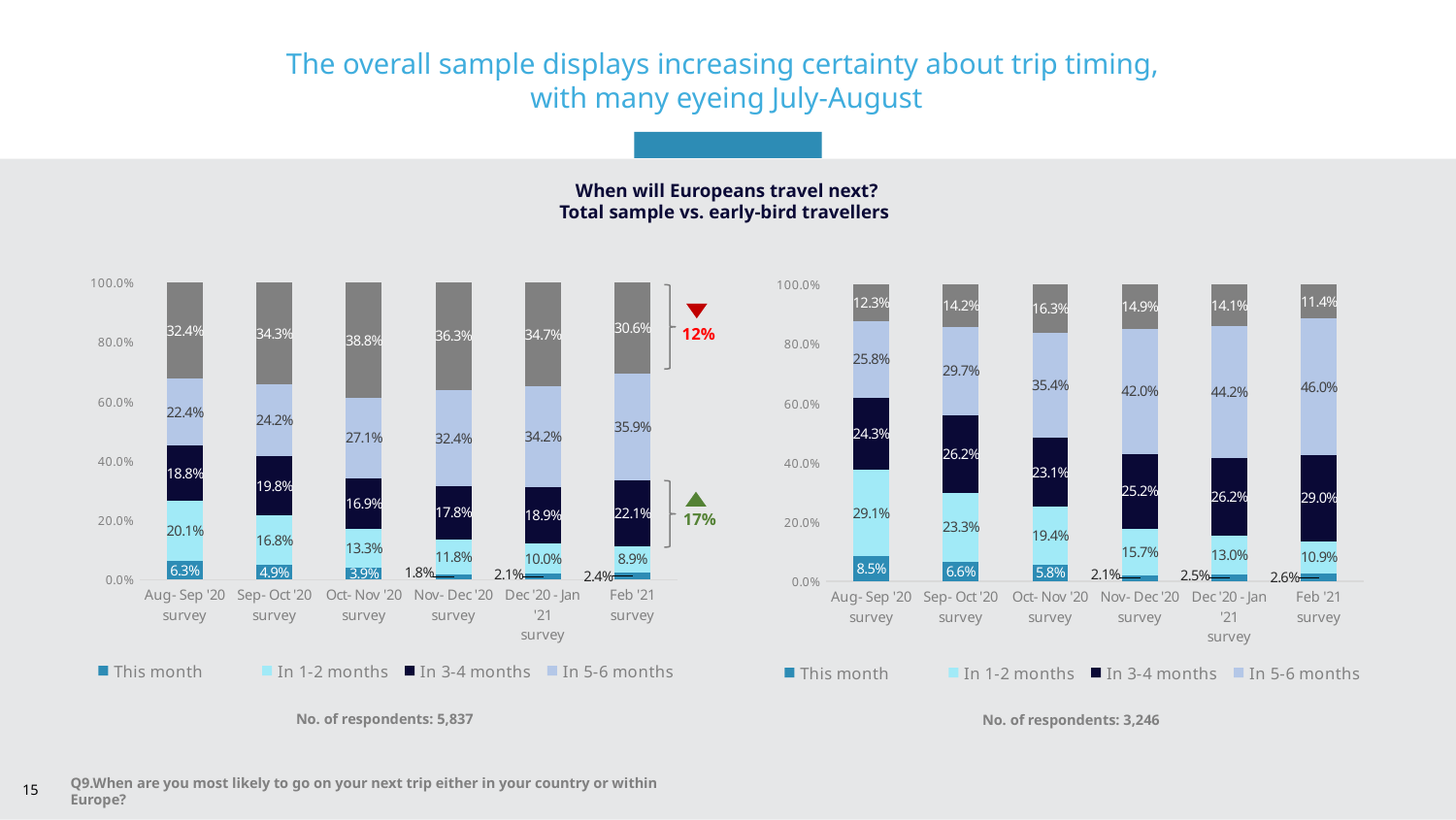
What kind of chart is the left chart (No. of respondents: 5,837)? Stacked bar chart How many surveys are shown on the x axis of the left chart (No. of respondents: 5,837)? 6 In the right chart (No. of respondents: 3,246), which is larger in the Sep-Oct '20 survey: 'In 3-4 months' or 'In 1-2 months'? In 3-4 months In the left chart (No. of respondents: 5,837), what is the value for 'In 5-6 months' in the Feb '21 survey? 35.9% In the left chart (No. of respondents: 5,837), what is the difference between the 'In 5-6 months' values for the Feb '21 survey and the Aug-Sep '20 survey? 13.5% What is the title shown above the two charts? When will Europeans travel next? Total sample vs. early-bird travellers How does the 'In 1-2 months' value change across the surveys from Aug-Sep '20 to Feb '21 in the right chart (No. of respondents: 3,246)? It falls In the right chart (No. of respondents: 3,246), what is the value for 'In 1-2 months' in the Aug-Sep '20 survey? 29.1% In the right chart (No. of respondents: 3,246), which survey has the highest value for 'In 5-6 months'? Feb '21 survey How many series does the legend of the right chart (No. of respondents: 3,246) list? 4 In the left chart (No. of respondents: 5,837), which survey has the lowest value for 'In 1-2 months'? Feb '21 survey In the left chart (No. of respondents: 5,837), what is the value for 'This month' in the Nov-Dec '20 survey? 1.8%